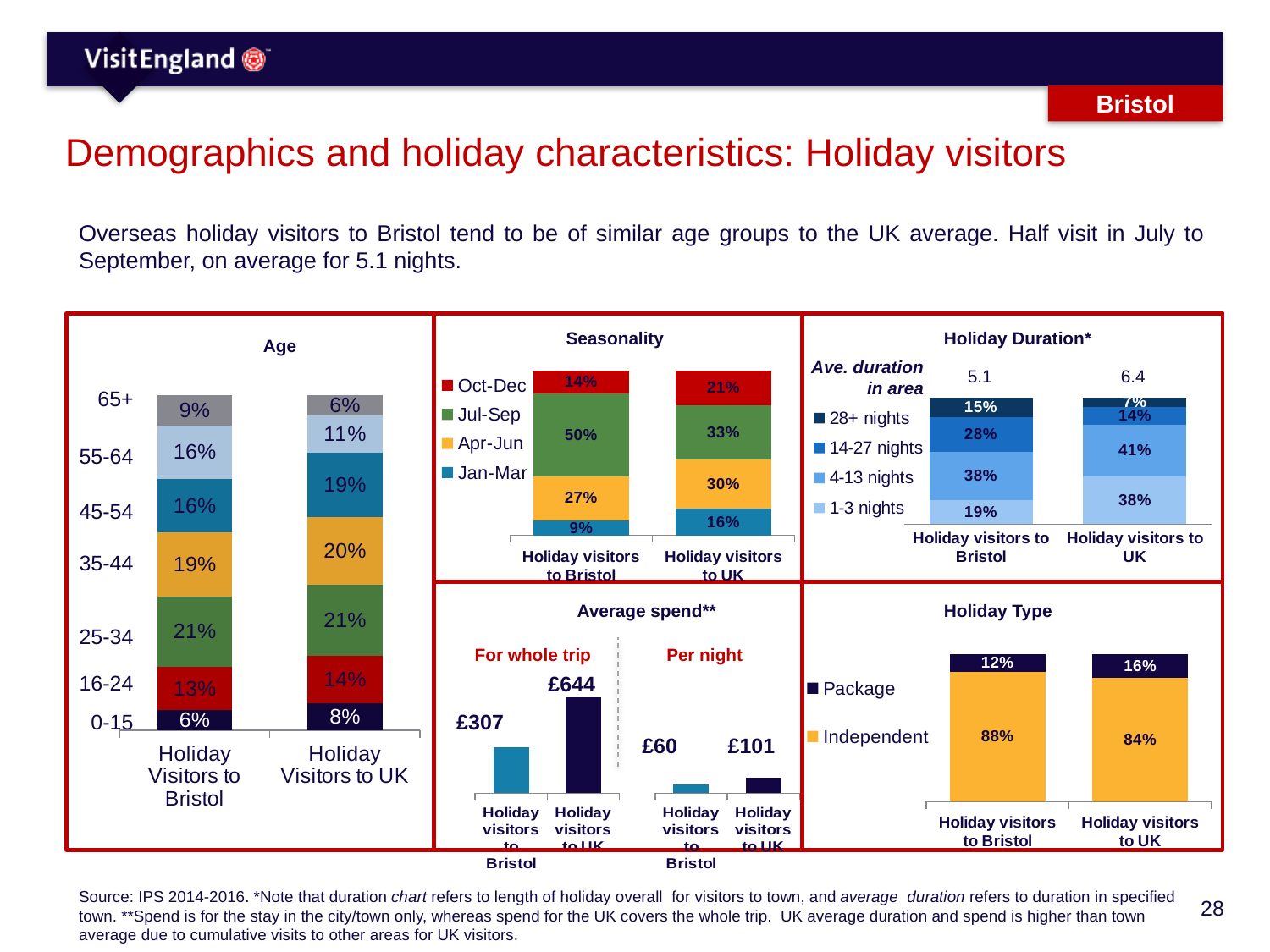
In the Average spend chart, what is the spend for the whole trip for holiday visitors to UK? £644 In the Age chart, which age group has the largest share of holiday visitors to UK? 25-34 In the Age chart, what is the difference between the 55-64 share for holiday visitors to Bristol and for holiday visitors to UK? 5% In the Age chart, what percentage of holiday visitors to Bristol are aged 25-34? 21% In the Holiday Duration chart, what is the average duration in area for holiday visitors to Bristol? 5.1 In the Average spend chart, what is the difference between per night spend for holiday visitors to UK and holiday visitors to Bristol? £41 In the Seasonality chart, what percentage of holiday visitors to Bristol visit in Jul-Sep? 50% In the Seasonality chart, which quarter has the lowest share of holiday visitors to Bristol? Jan-Mar In the Holiday Type chart, which is larger: the Independent share for holiday visitors to Bristol or for holiday visitors to UK? Holiday visitors to Bristol In the Holiday Type chart, what percentage of holiday visitors to Bristol are on a package holiday? 12% In the Holiday Duration chart, what percentage of holiday visitors to Bristol stay 4-13 nights? 38% How many series does the legend of the Seasonality chart list? 4